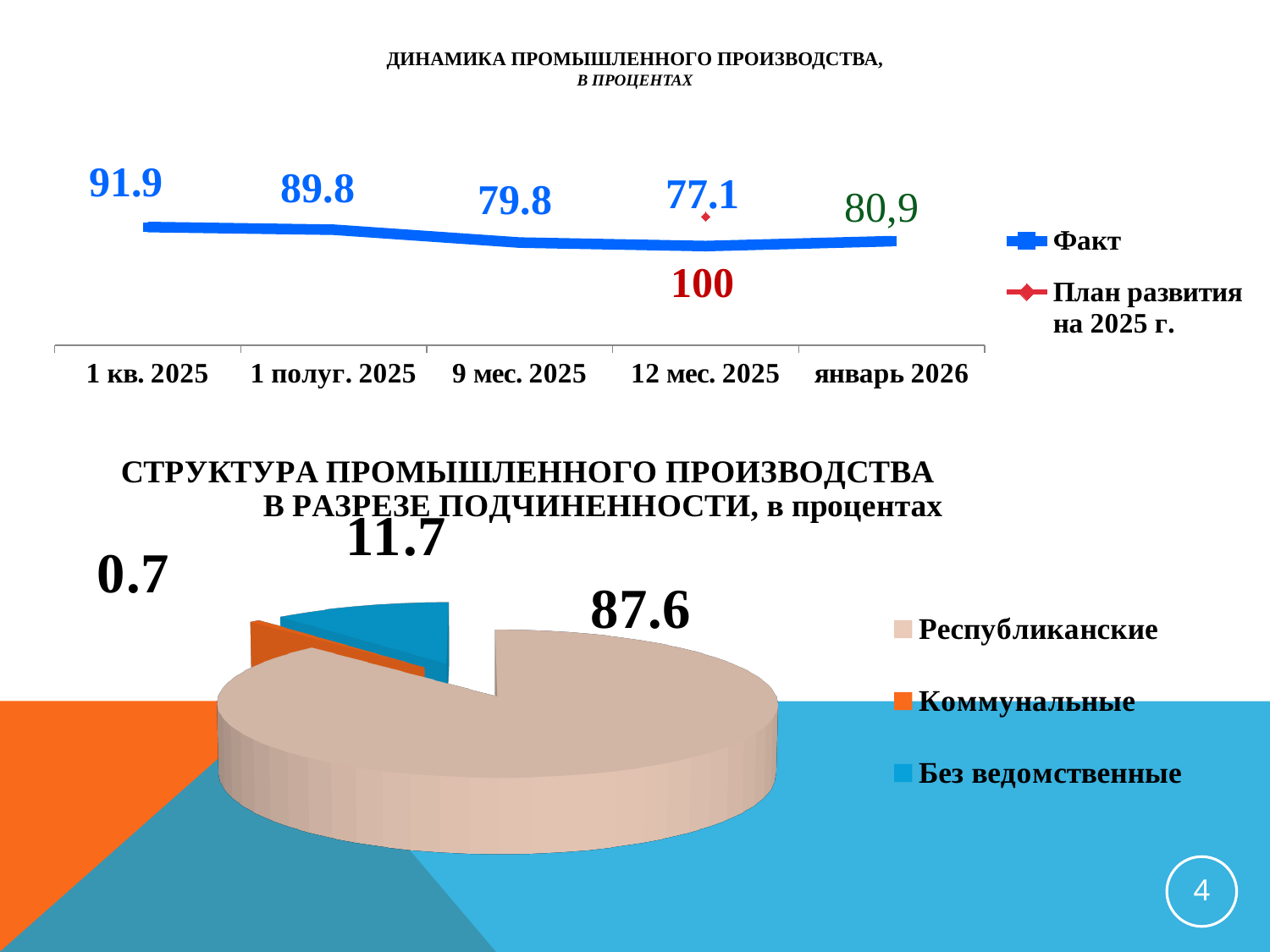
In the line chart 'Динамика промышленного производства', how many series does the legend list? 2 In the line chart 'Динамика промышленного производства', what is the Факт value for 1 кв. 2025? 91.9 In the chart 'Структура промышленного производства в разрезе подчиненности', which category has the largest share? Республиканские In the line chart 'Динамика промышленного производства', what is the Факт value for 9 мес. 2025? 79.8 What kind of chart is 'Структура промышленного производства в разрезе подчиненности'? pie chart In the line chart 'Динамика промышленного производства', how many periods are shown on the x axis? 5 In the chart 'Структура промышленного производства в разрезе подчиненности', what is the value for Коммунальные? 0.7 In the line chart 'Динамика промышленного производства', what is the difference between the Факт value for 1 кв. 2025 and the Факт value for 12 мес. 2025? 14.8 In the line chart 'Динамика промышленного производства', what is the value of 'План развития на 2025 г.' shown at 12 мес. 2025? 100 In the line chart 'Динамика промышленного производства', which period has the highest Факт value? 1 кв. 2025 In the line chart 'Динамика промышленного производства', does the Факт value rise or fall from 1 кв. 2025 to 12 мес. 2025? fall In the line chart 'Динамика промышленного производства', which period has the lowest Факт value? 12 мес. 2025